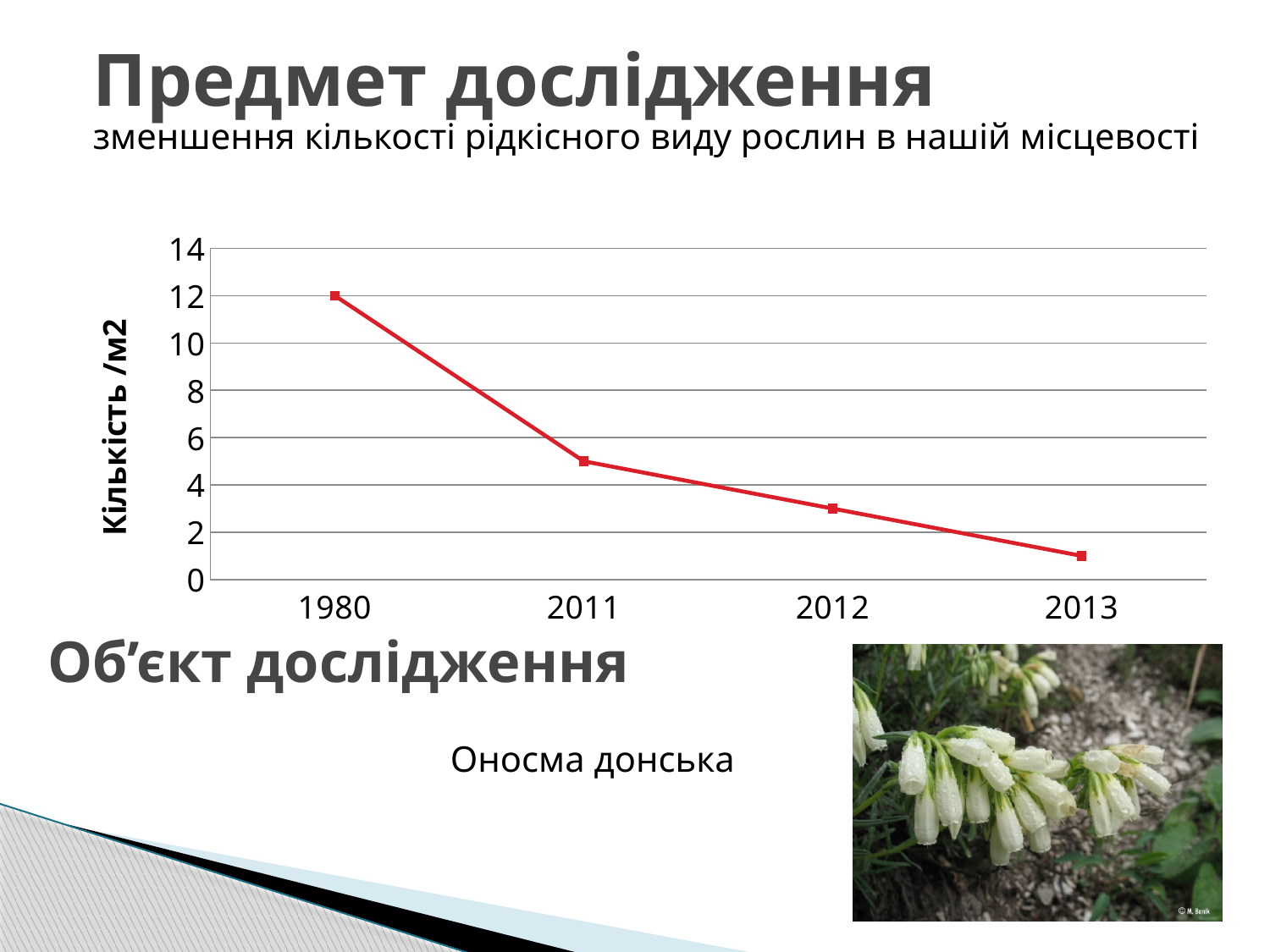
What is the label of the vertical axis? Кількість /м2 Which year has the highest value? 1980 How many years are plotted on the x axis? 4 What is the value for 1980? 12 Is the value for 2011 greater or less than 4? greater Is the value for 2012 greater or less than 4? less Which is larger, the value for 2011 or the value for 2012? 2011 Is the value for 2013 greater or less than 2? less Which year has the lowest value? 2013 What kind of chart is shown on the slide? line chart Do the values rise or fall from 1980 to 2013? fall